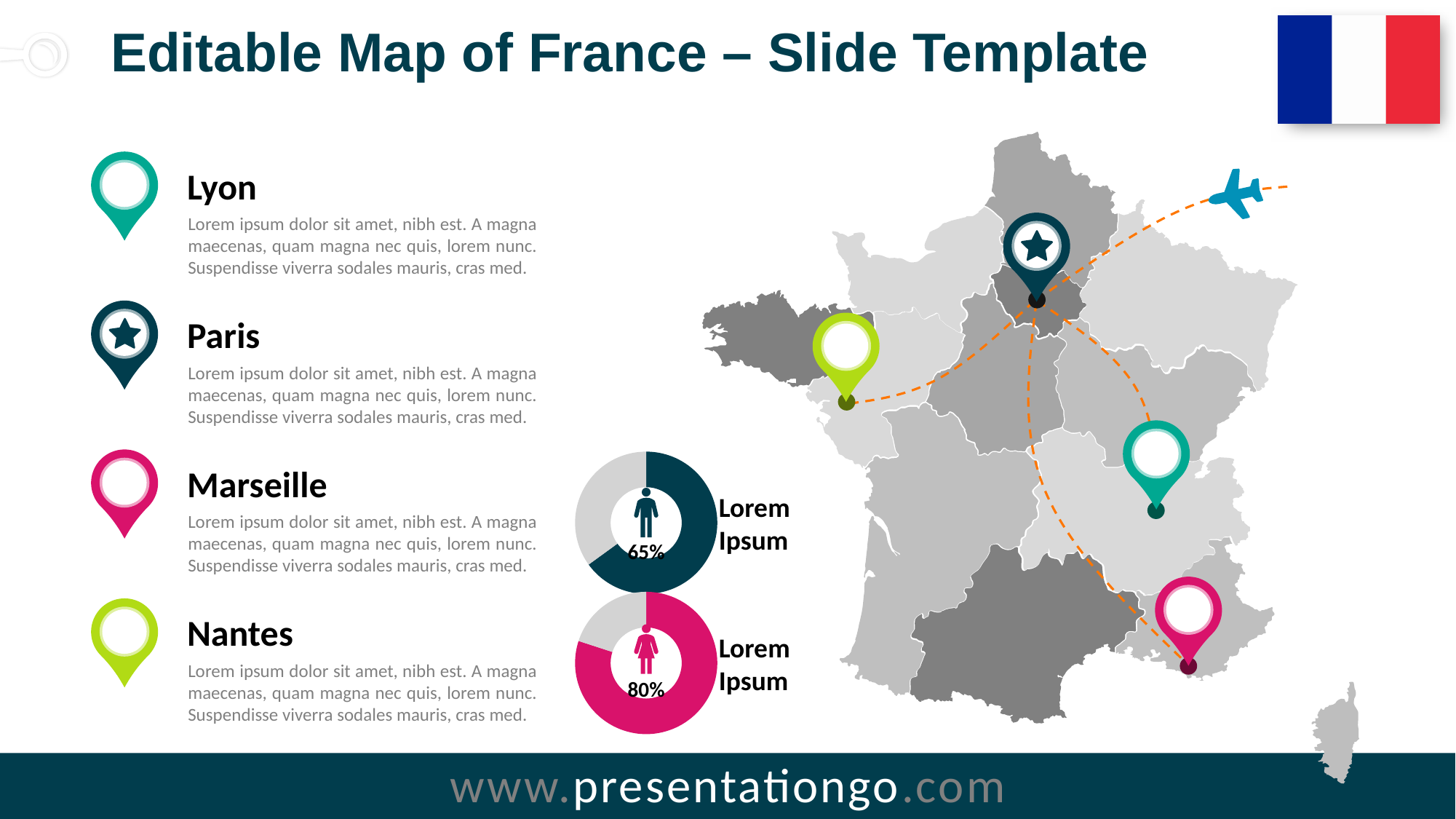
What is the difference between the percentage in the bottom donut chart (80%) and the top donut chart (65%)? 15 percentage points How many donut charts are shown on the slide? 2 In the bottom donut chart with the female figure icon, what percentage is shown? 80% What colour is the filled portion of the bottom donut chart (female icon)? magenta/pink In the top donut chart, what share of the ring is left unfilled (grey) given the 65% value? 35% In the bottom donut chart, what share of the ring is left unfilled (grey) given the 80% value? 20% Which donut chart shows the larger percentage, the top one (male icon) or the bottom one (female icon)? the bottom one (female icon), 80% What kind of chart is used to display the 65% and 80% values on the slide? donut chart Is the value shown in the top donut chart (male icon) greater or less than 50%? greater What text label appears to the right of each donut chart? Lorem Ipsum In the top donut chart with the male figure icon, what percentage is shown? 65%